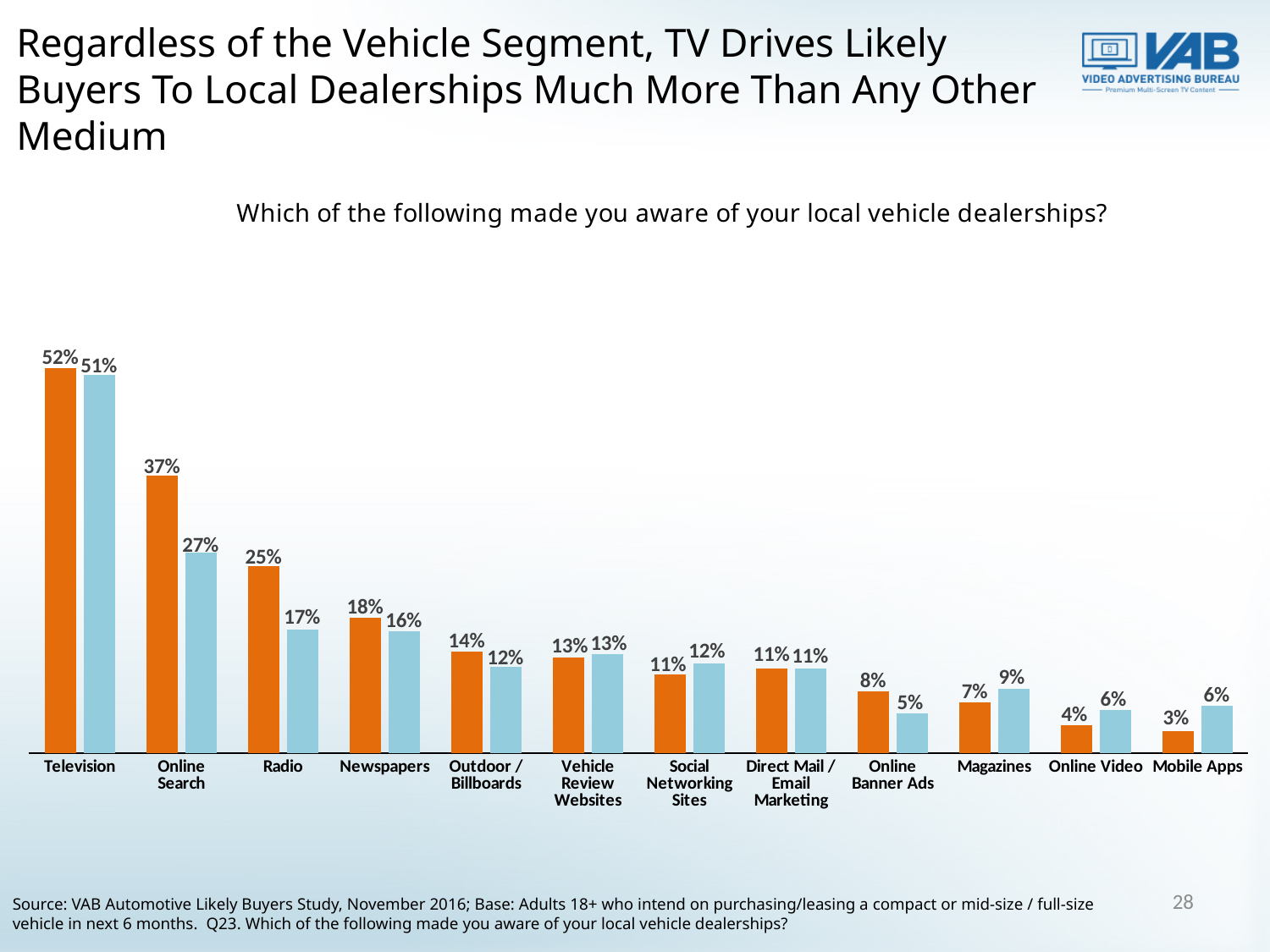
How many categories are shown on the x axis? 12 What is the orange bar value for Radio? 25% What is the difference between the orange and light blue bars for Online Search? 10% What is the light blue bar value for Online Search? 27% Which category has the highest orange bar value? Television What is the orange bar value for Television? 52% What kind of chart is shown on the slide? bar chart What is the difference between the orange bar values for Television and Radio? 27% Which category has the lowest orange bar value? Mobile Apps Which is larger, the orange bar for Newspapers or the orange bar for Outdoor / Billboards? Newspapers For Online Video, which bar is larger, the orange or the light blue? light blue What is the light blue bar value for Magazines? 9%